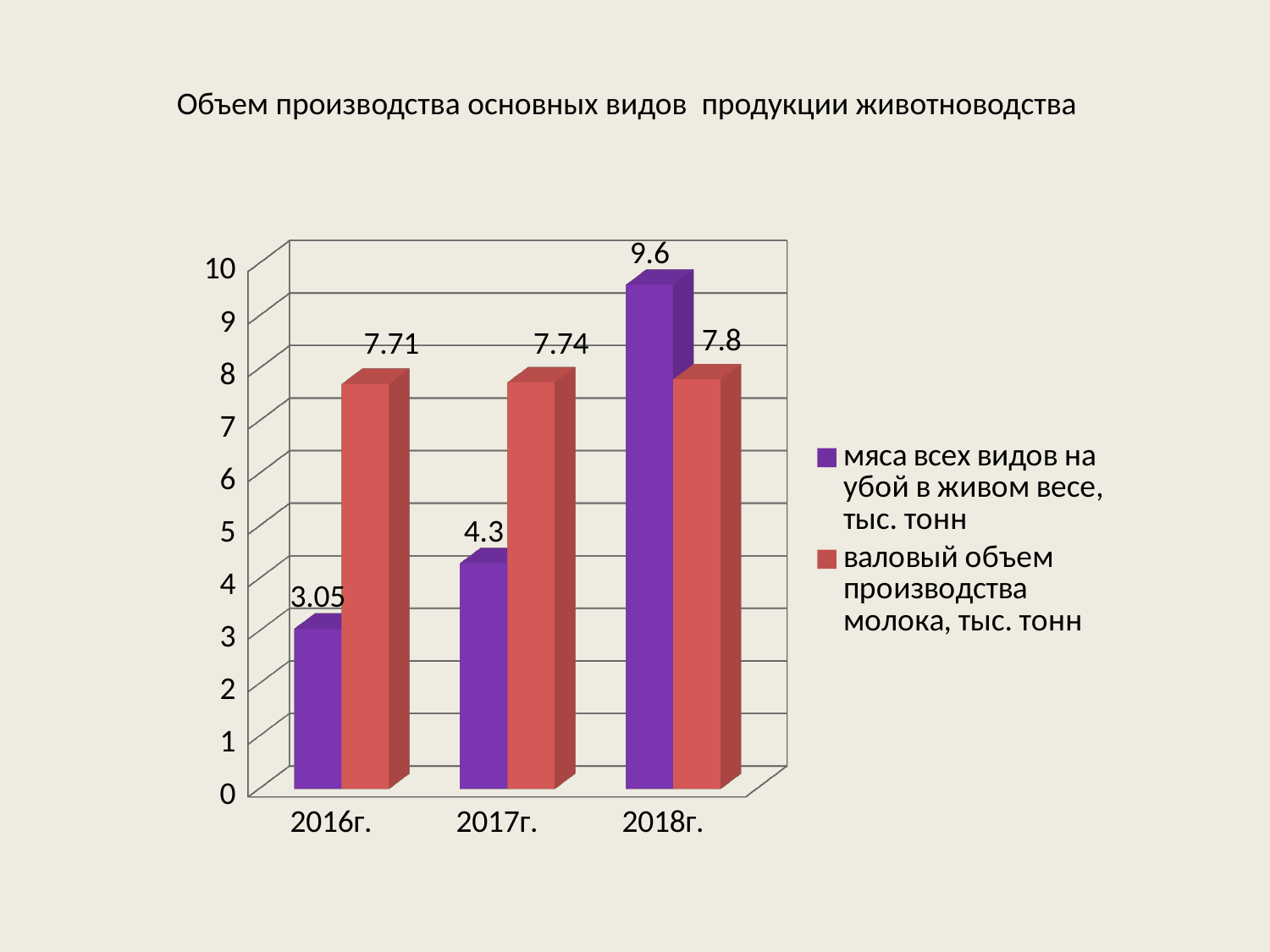
How many series does the legend list? 2 What is the difference between the milk production value and the meat production value in 2016г.? 4.66 What is the value for meat of all kinds for slaughter in live weight in 2018г.? 9.6 Does the meat production value rise or fall from 2016г. to 2018г.? Rise What colour are the bars for gross milk production? Red Which is larger in 2018г.: meat production or milk production? Meat production (9.6) How many years are shown on the x axis? 3 What is the gross volume of milk production (валовый объем производства молока) in 2017г.? 7.74 What is the value for meat of all kinds for slaughter in live weight (мяса всех видов на убой в живом весе) in 2016г.? 3.05 What kind of chart is shown on the slide? Bar chart In which year is the meat production value the lowest? 2016г. In which year is the meat production value the highest? 2018г.